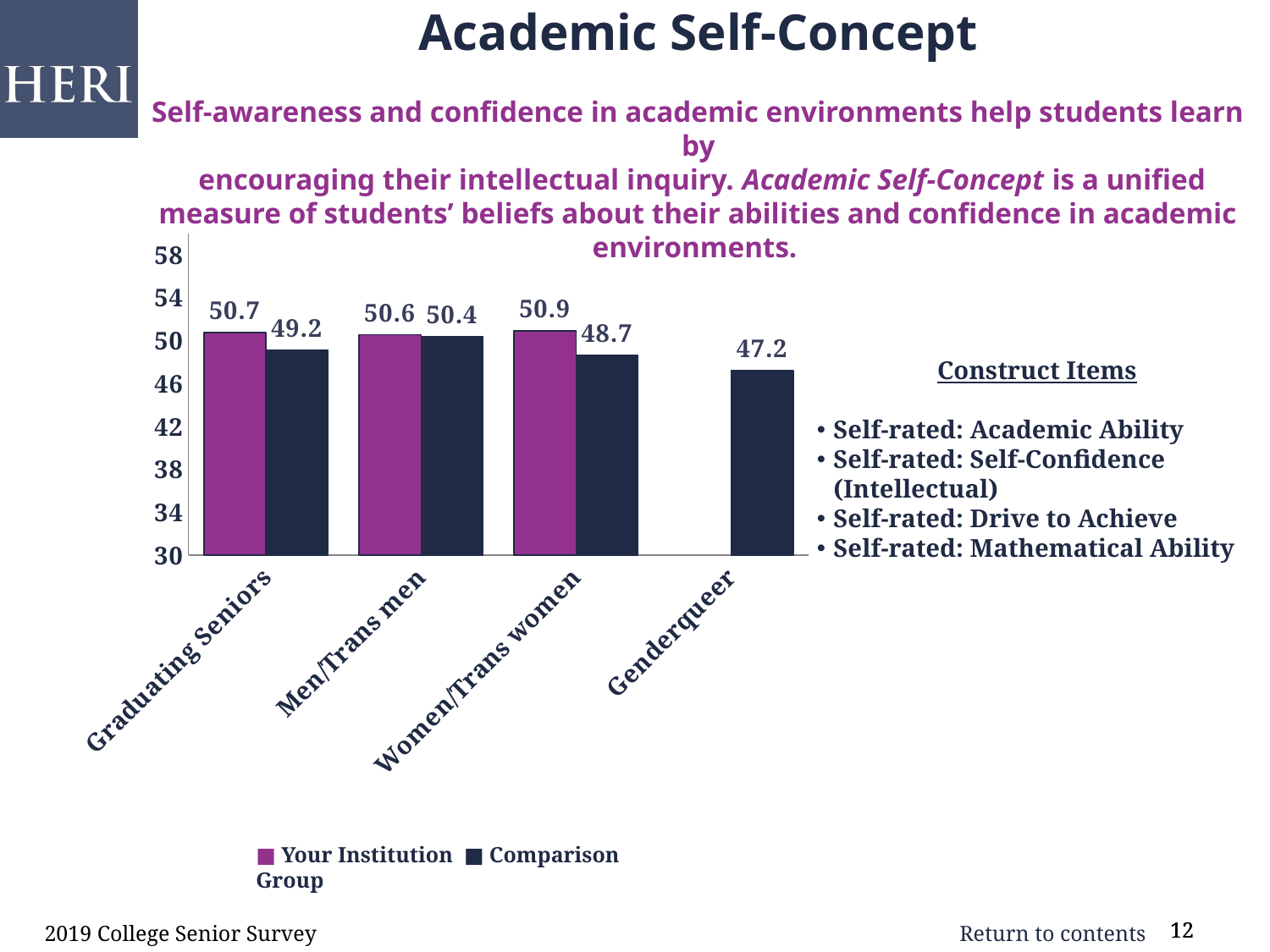
How many categories are shown on the x axis? 4 What is the Your Institution value for Graduating Seniors? 50.7 What is the Comparison Group value for Genderqueer? 47.2 Which is larger for Men/Trans men: the Your Institution value or the Comparison Group value? Your Institution What kind of chart is shown on the slide? Bar chart How many series does the legend list? 2 Which category has the lowest Comparison Group value? Genderqueer What is the difference between the Your Institution and Comparison Group values for Women/Trans women? 2.2 What is the Your Institution value for Men/Trans men? 50.6 Which category has the highest Your Institution value? Women/Trans women What is the Comparison Group value for Women/Trans women? 48.7 What is the difference between the Your Institution and Comparison Group values for Graduating Seniors? 1.5